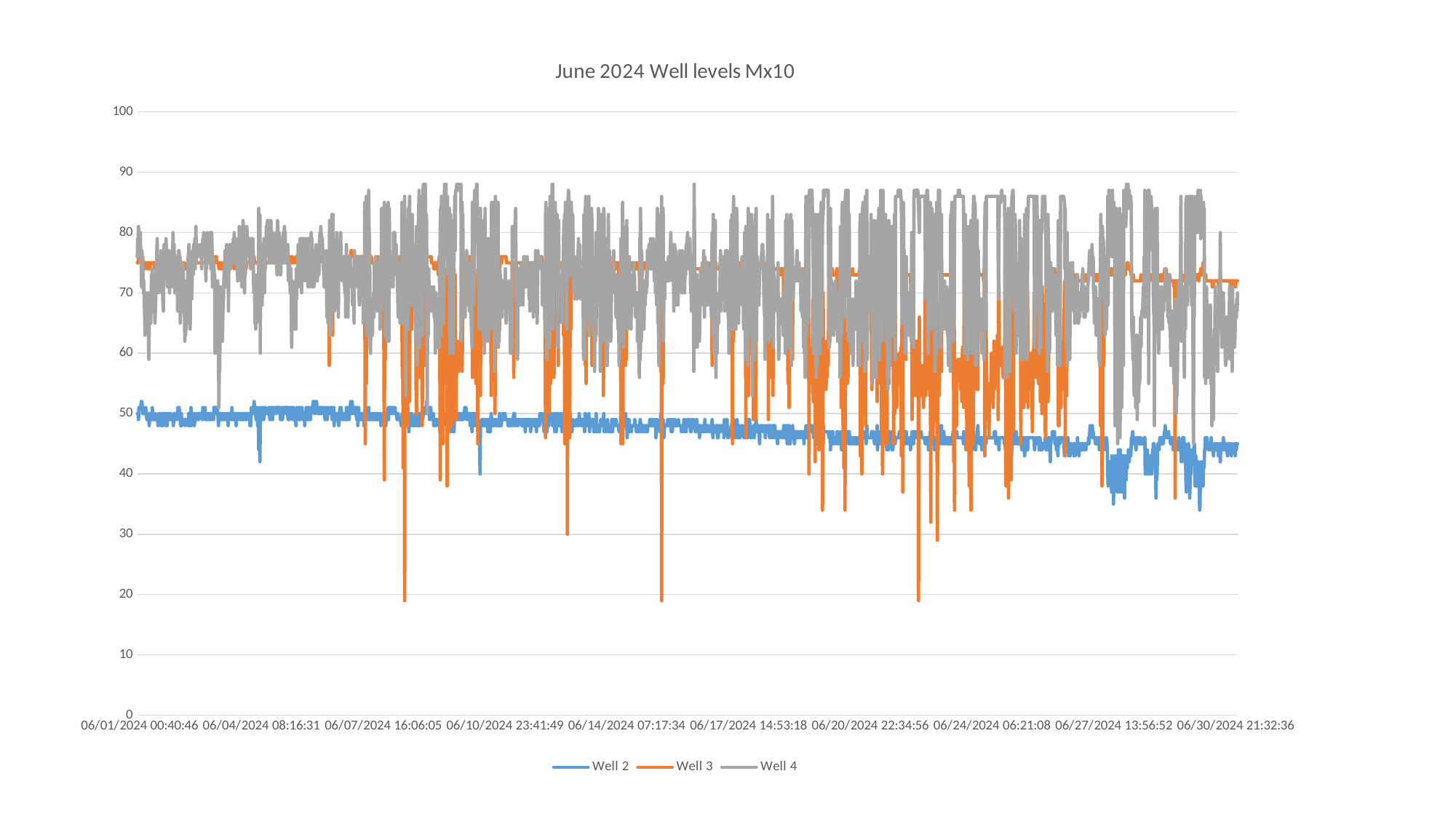
What kind of chart is shown on the slide? line chart Is the value for Well 4 at the start of June greater or less than 60? greater How many series does the legend list? 3 Which series has the highest values for most of the month? Well 4 Does the Well 2 line generally rise or fall from the start of June to the end of June? fall Which series has the lowest values for most of the month? Well 2 What is the title of the chart? June 2024 Well levels Mx10 Is the value for Well 2 at the start of June greater or less than 60? less Does Well 4 ever rise above 90 during the month? no At the start of June, which is larger, Well 2 or Well 4? Well 4 Which series is drawn in orange? Well 3